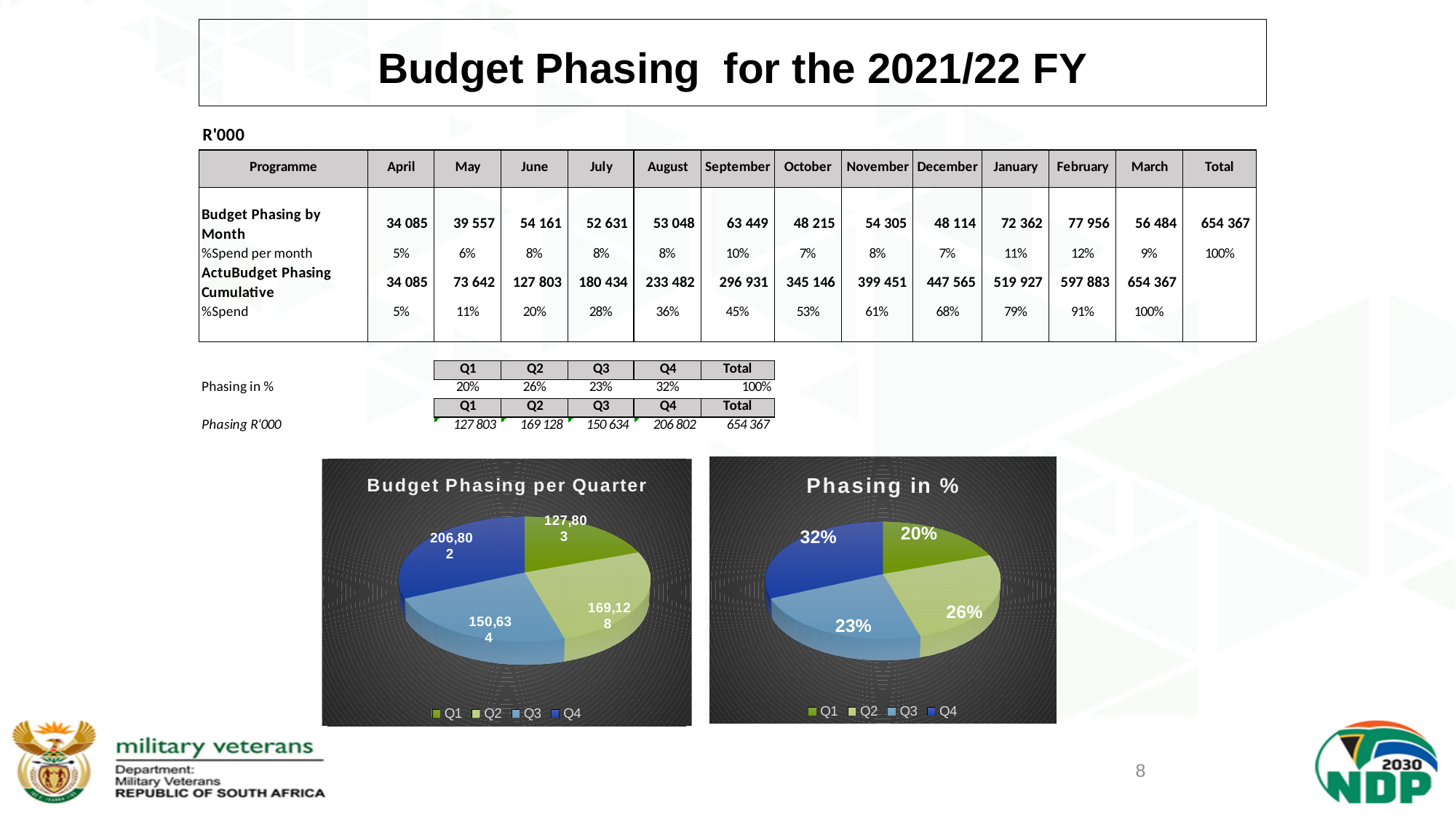
In the 'Budget Phasing per Quarter' chart, what is the value for Q4? 206,802 In the 'Budget Phasing per Quarter' chart, which is larger, Q2 or Q3? Q2 What type of chart is 'Budget Phasing per Quarter'? Pie chart In the 'Budget Phasing per Quarter' chart, what is the value for Q1? 127,803 How many entries does the legend of the 'Phasing in %' chart list? 4 In the 'Phasing in %' chart, which quarter has the smallest share? Q1 In the 'Budget Phasing per Quarter' chart, which quarter has the highest value? Q4 In the 'Phasing in %' chart, what share does Q3 have? 23% In the 'Budget Phasing per Quarter' chart, which quarter has the lowest value? Q1 How many slices does the 'Phasing in %' chart have? 4 In the 'Phasing in %' chart, what share does Q4 have? 32% In the 'Budget Phasing per Quarter' chart, what is the difference between the Q2 and Q3 values? 18,494